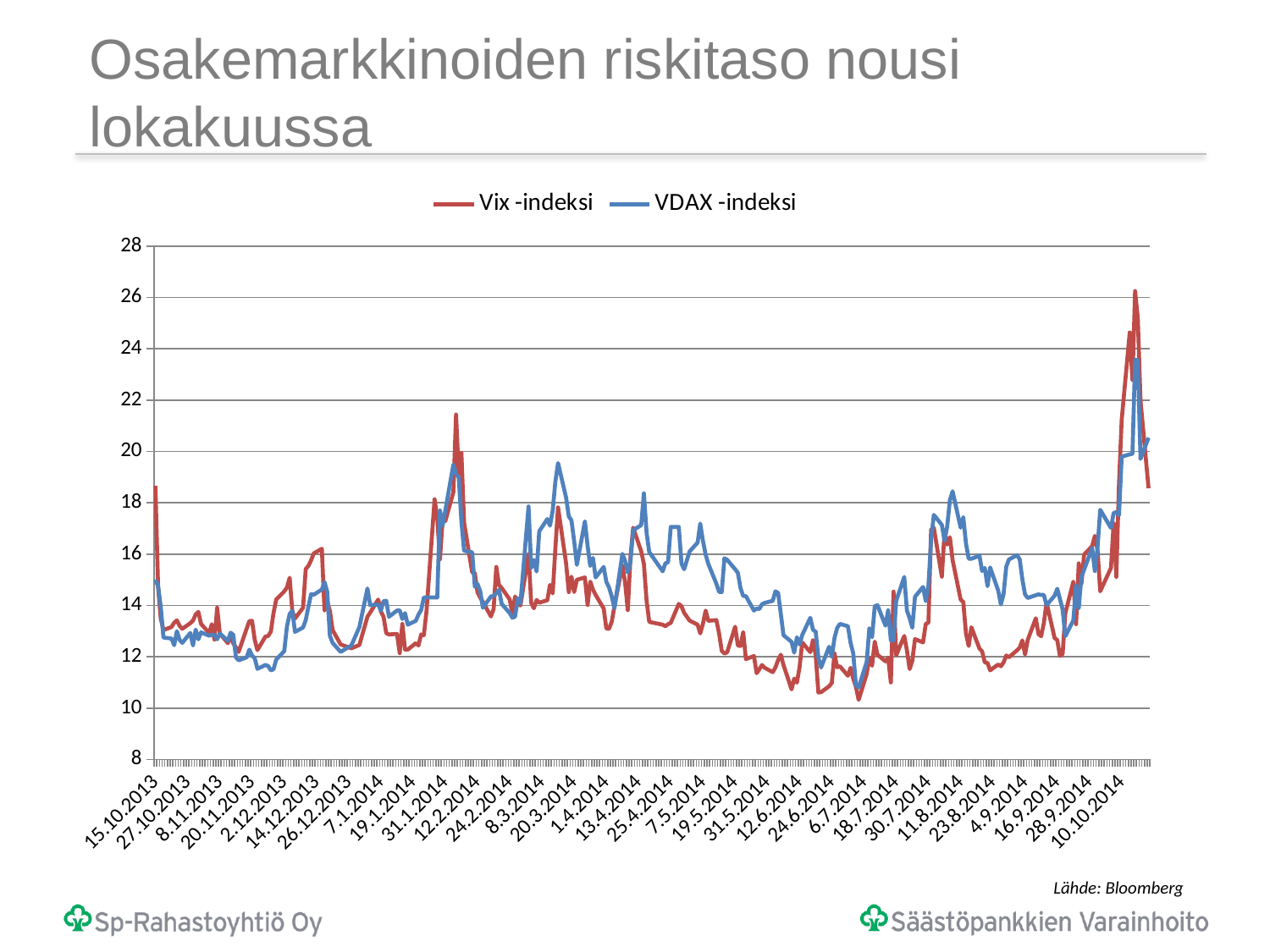
Is the lowest value of the Vix -indeksi line (around early July 2014) greater or less than 12? less What is the maximum value shown on the vertical axis? 28 Is the value of the VDAX -indeksi line at 15.10.2013 greater or less than 16? less Is the highest value of the VDAX -indeksi line (in October 2014) greater or less than 22? greater Around 7.5.2014, which series is higher, Vix -indeksi or VDAX -indeksi? VDAX -indeksi Do the two lines rise or fall between 28.9.2014 and 10.10.2014? rise How many series does the legend list? 2 What kind of chart is shown on the slide? line chart Which colour is used for the Vix -indeksi line? red What are the two series named in the legend? Vix -indeksi and VDAX -indeksi At the peak in October 2014, which series reaches the higher value, Vix -indeksi or VDAX -indeksi? Vix -indeksi